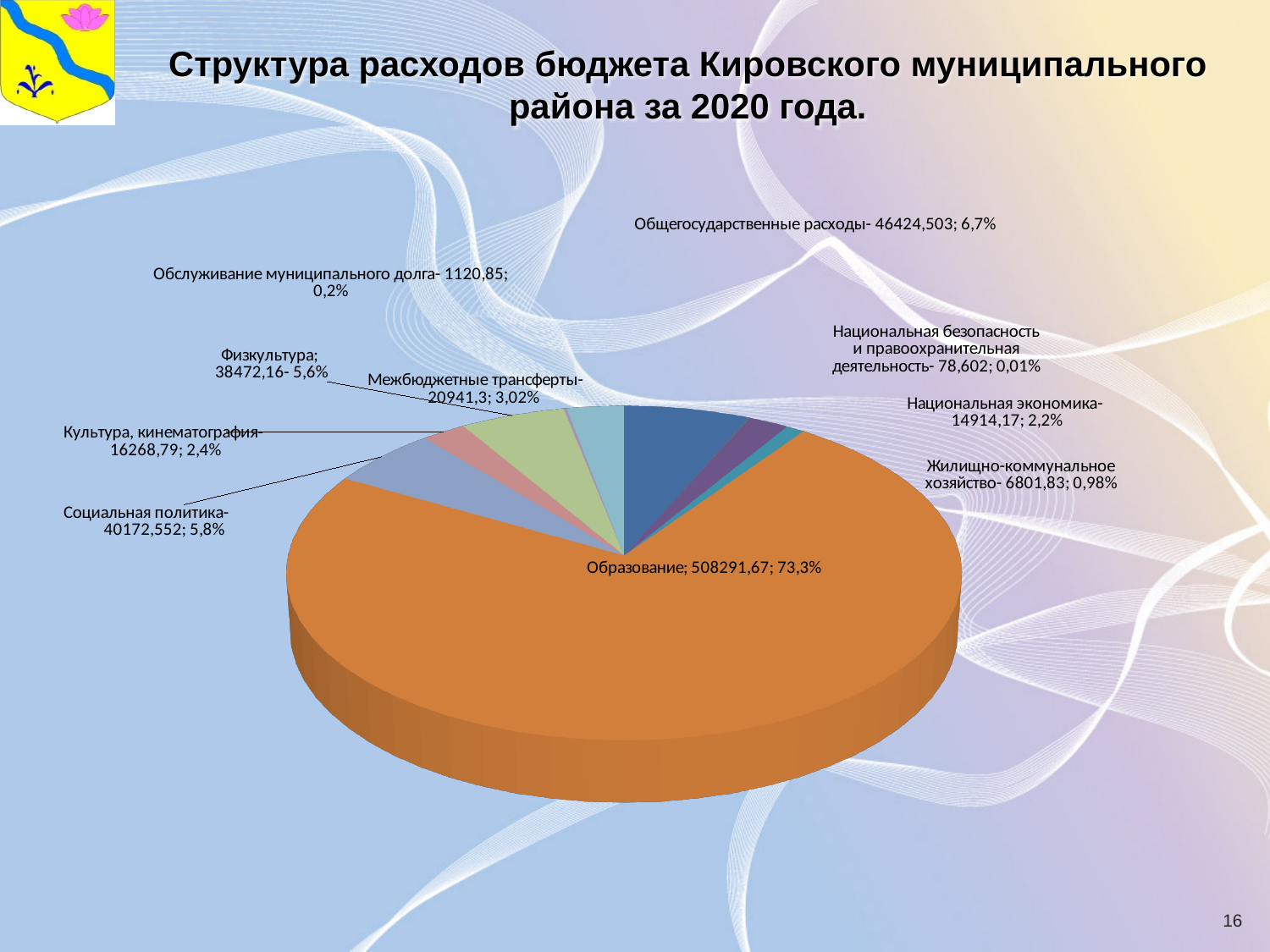
What kind of chart is shown on the slide? Pie chart What value is shown for Образование? 508291,67 What is the difference between the values for Общегосударственные расходы and Социальная политика? 6251,951 What value is shown for Социальная политика? 40172,552 Which category has the smallest slice of the pie chart? Национальная безопасность и правоохранительная деятельность Which category has the largest slice of the pie chart? Образование How many categories (slices) does the pie chart show? 10 What share of the pie does Образование account for? 73,3% Which is larger, Общегосударственные расходы or Социальная политика? Общегосударственные расходы What share of the pie does Межбюджетные трансферты account for? 3,02% What value is shown for Обслуживание муниципального долга? 1120,85 What is the title of the chart on the slide? Структура расходов бюджета Кировского муниципального района за 2020 года.